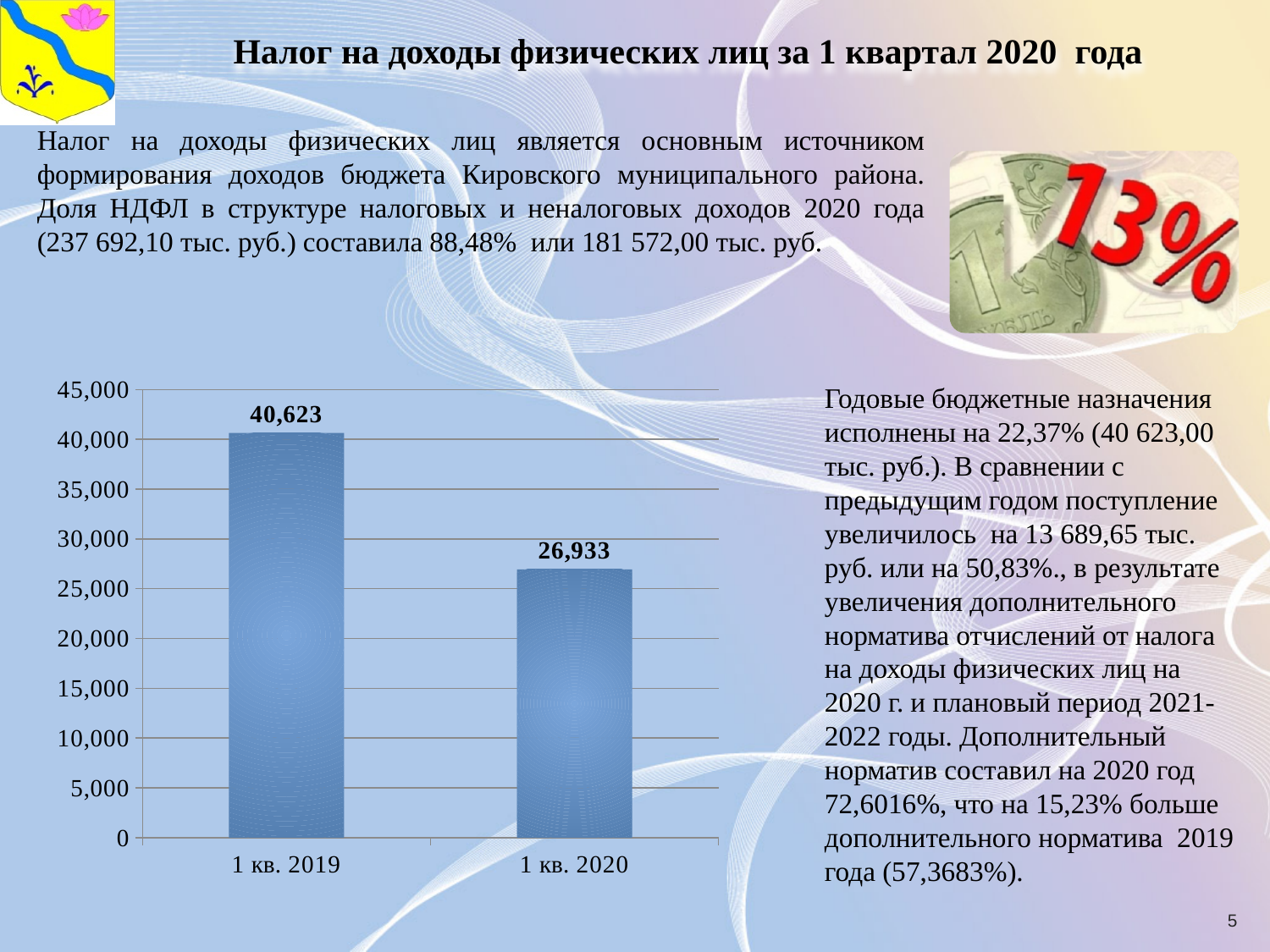
Is the value for 1 кв. 2019 greater or less than 40,000? greater What kind of chart is shown on the slide? bar chart What is the value for 1 кв. 2019 in the bar chart? 40,623 Do the values rise or fall from 1 кв. 2019 to 1 кв. 2020 in the chart? fall What is the maximum value shown on the vertical axis of the chart? 45,000 Is the value for 1 кв. 2020 greater or less than 30,000? less What is the value for 1 кв. 2020 in the bar chart? 26,933 Which category has the lowest value in the bar chart? 1 кв. 2020 What is the difference between the values for 1 кв. 2019 and 1 кв. 2020? 13,690 How many categories are shown in the bar chart? 2 Which category has the highest value in the bar chart? 1 кв. 2019 Which is larger: the value for 1 кв. 2019 or the value for 1 кв. 2020? 1 кв. 2019